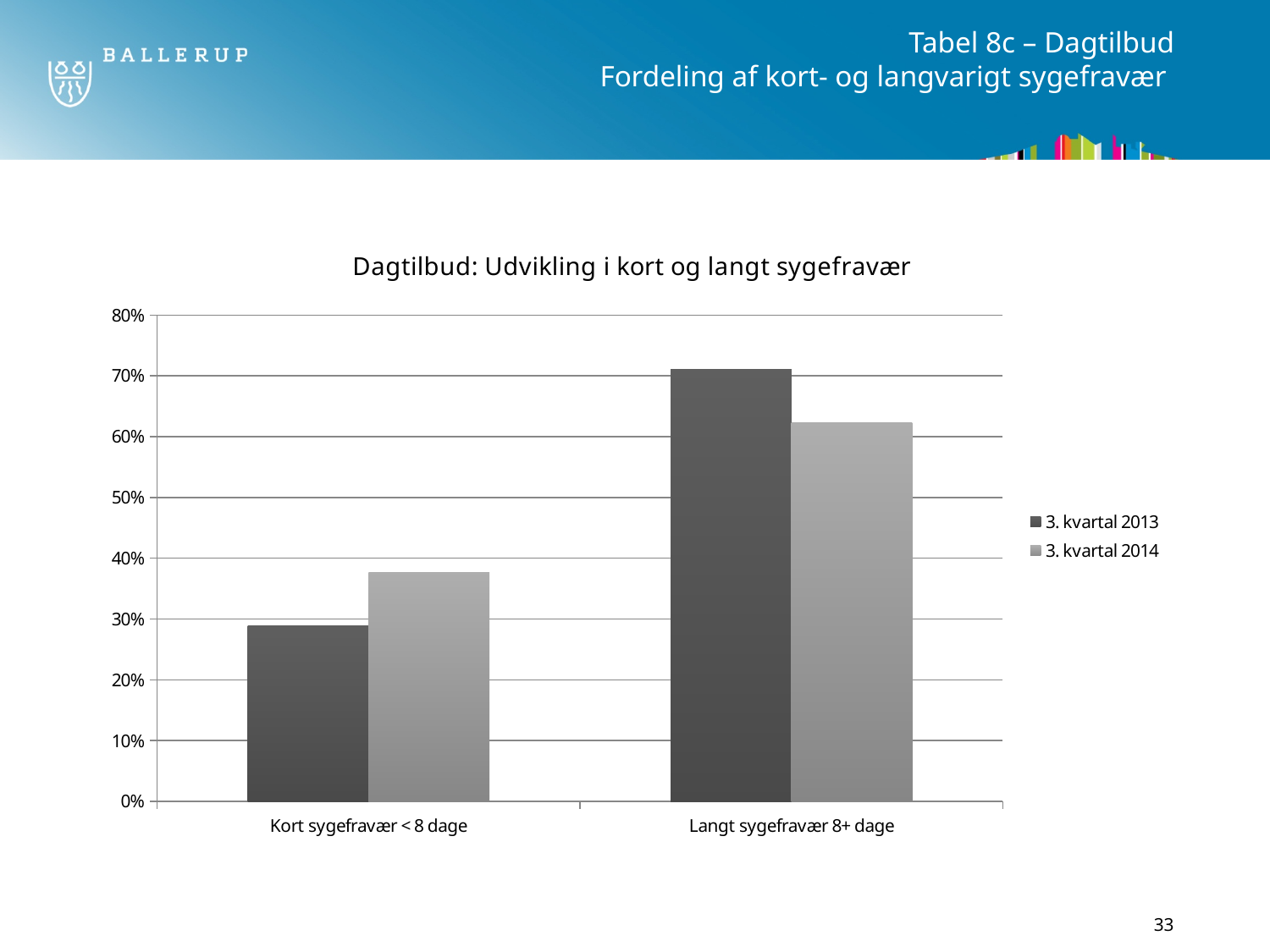
For Langt sygefravær 8+ dage, which is larger: 3. kvartal 2013 or 3. kvartal 2014? 3. kvartal 2013 How many categories are shown on the x axis? 2 Is the value for Kort sygefravær < 8 dage in 3. kvartal 2013 greater or less than 30%? less Is the value for Langt sygefravær 8+ dage in 3. kvartal 2014 greater or less than 70%? less What is the title of the chart? Dagtilbud: Udvikling i kort og langt sygefravær For Kort sygefravær < 8 dage, which is larger: 3. kvartal 2013 or 3. kvartal 2014? 3. kvartal 2014 Is the value for Langt sygefravær 8+ dage in 3. kvartal 2013 greater or less than 70%? greater How many series does the legend list? 2 Which category has the highest value for 3. kvartal 2013? Langt sygefravær 8+ dage What kind of chart is shown on the slide? bar chart Which series does the legend list first? 3. kvartal 2013